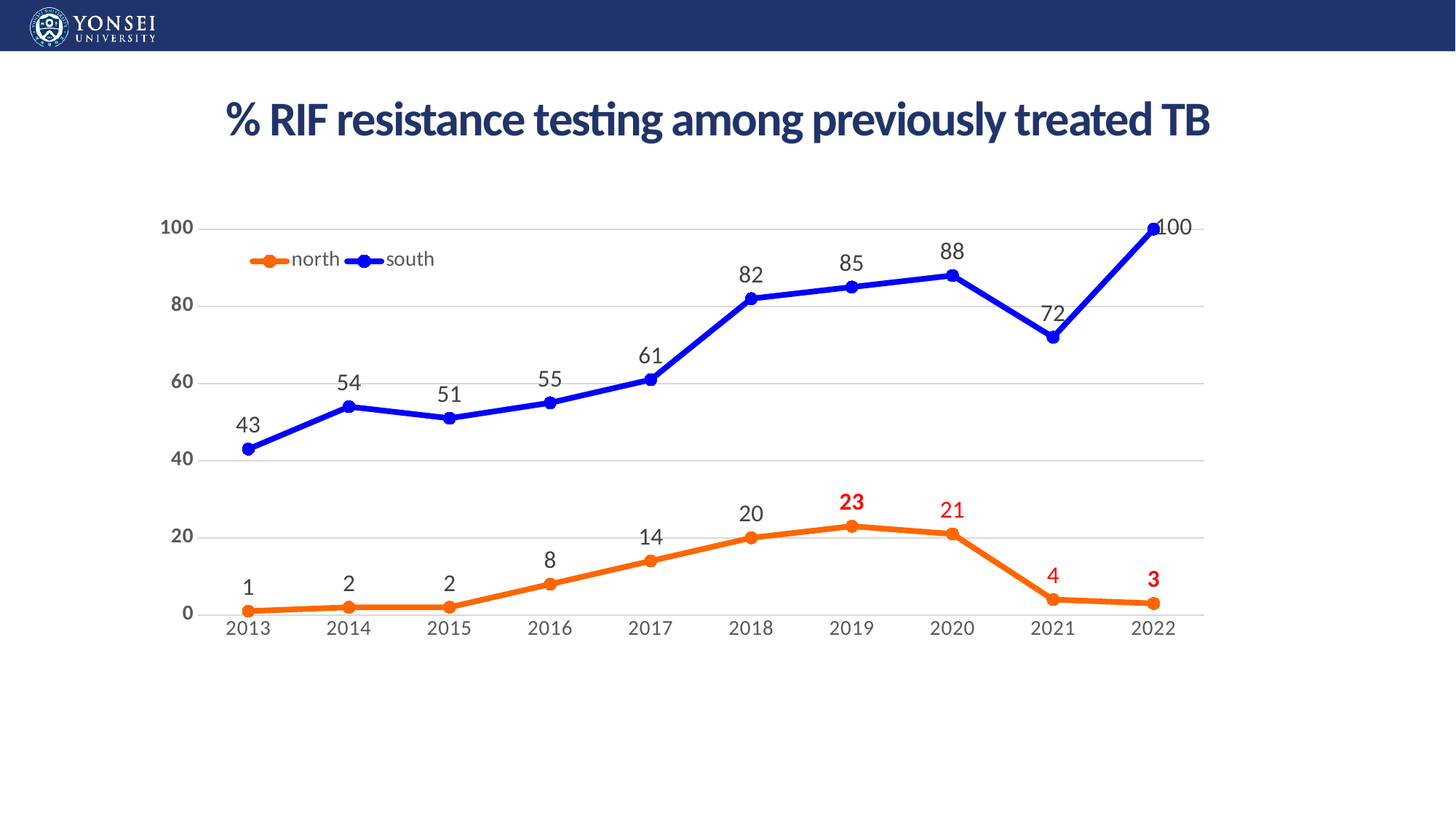
What is the value for north in 2019? 23 What is the value for south in 2013? 43 What is the title of the chart? % RIF resistance testing among previously treated TB Does the north series rise or fall from 2020 to 2022? fall Which is larger, the south value in 2021 or the south value in 2020? 2020 In which year does the north series reach its highest value? 2019 What is the difference between the south and north values in 2022? 97 How many years are shown on the x axis? 10 What is the value for south in 2018? 82 How many series does the legend list? 2 What kind of chart is shown on the slide? line chart In which year does the south series reach its lowest value? 2013